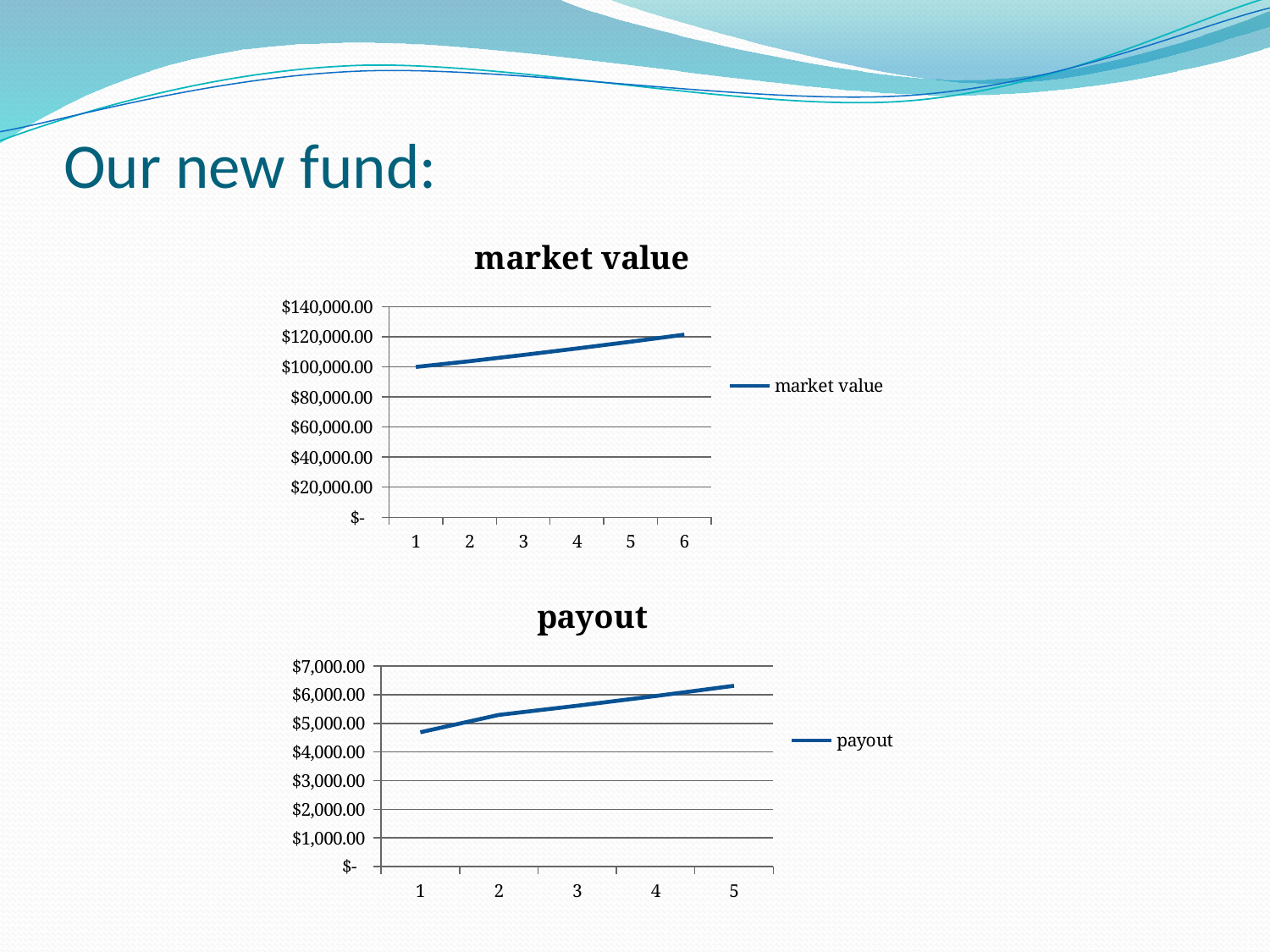
What type of chart is the "market value" chart? line chart What is the legend entry shown in the "payout" chart? payout In the "market value" chart, at which x-axis point is the market value lowest? 1 What type of chart is the "payout" chart? line chart In the "market value" chart, do the values rise or fall from point 1 to point 6? rise In the "payout" chart, is the value at point 1 greater or less than $5,000.00? less In the "market value" chart, at which x-axis point is the market value highest? 6 In the "payout" chart, is the value at point 5 greater or less than $6,000.00? greater How many points are plotted along the x axis of the "payout" chart? 5 How many points are plotted along the x axis of the "market value" chart? 6 How many series does the legend of the "market value" chart list? 1